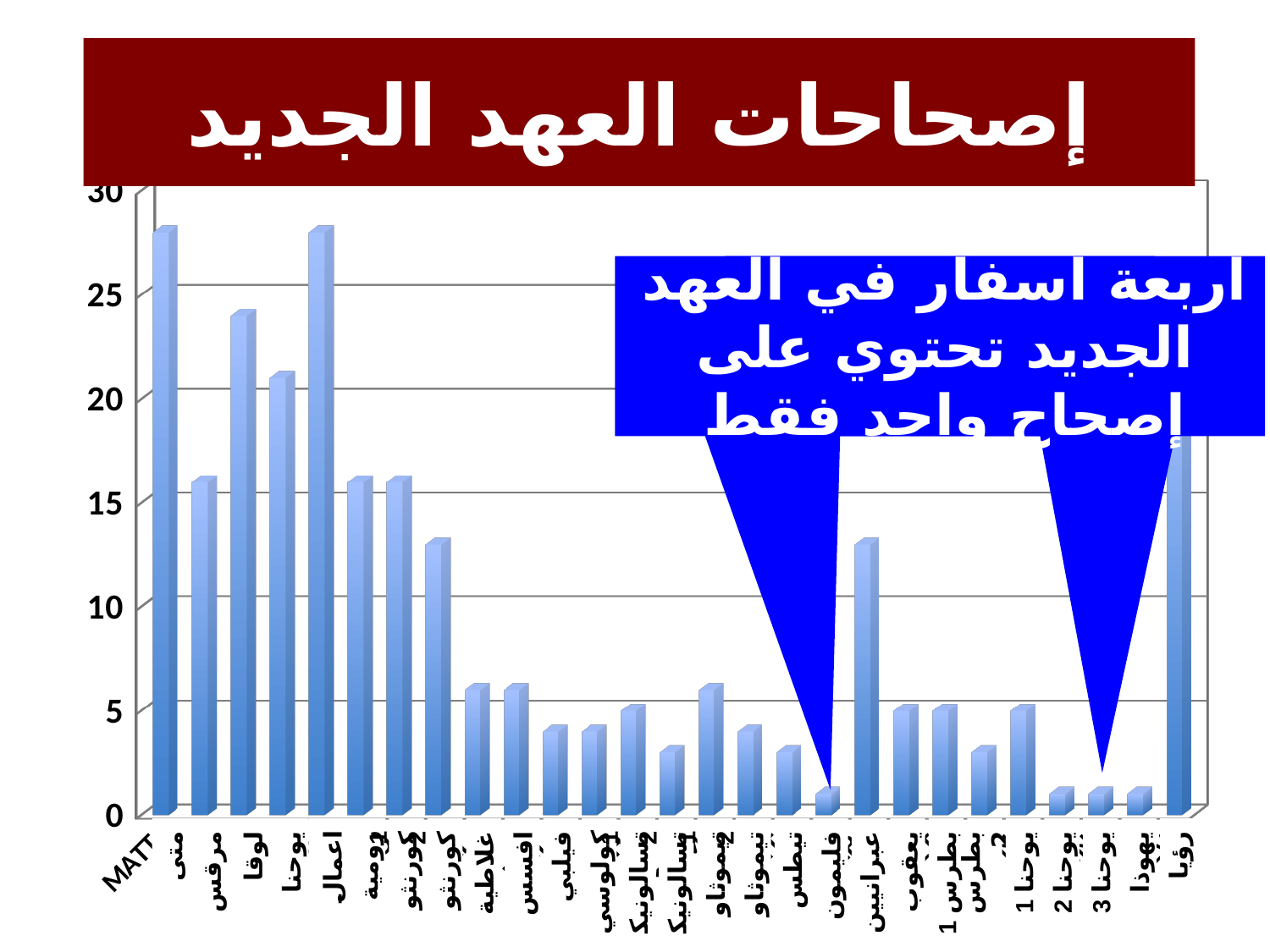
Is the value for اعمال greater or less than 25? greater Which has the larger value, لوقا or مرقس? لوقا According to the blue callout on the chart, how many books of the New Testament contain only one chapter? اربعة (four) What kind of chart is shown on the slide? bar chart Is the value for لوقا greater or less than 20? greater What is the title of the chart on the slide? إصحاحات العهد الجديد Is the value for تيطس greater or less than 5? less Which has the larger value, عبرانيين or يعقوب? عبرانيين How many categories (bars) are plotted along the x axis? 27